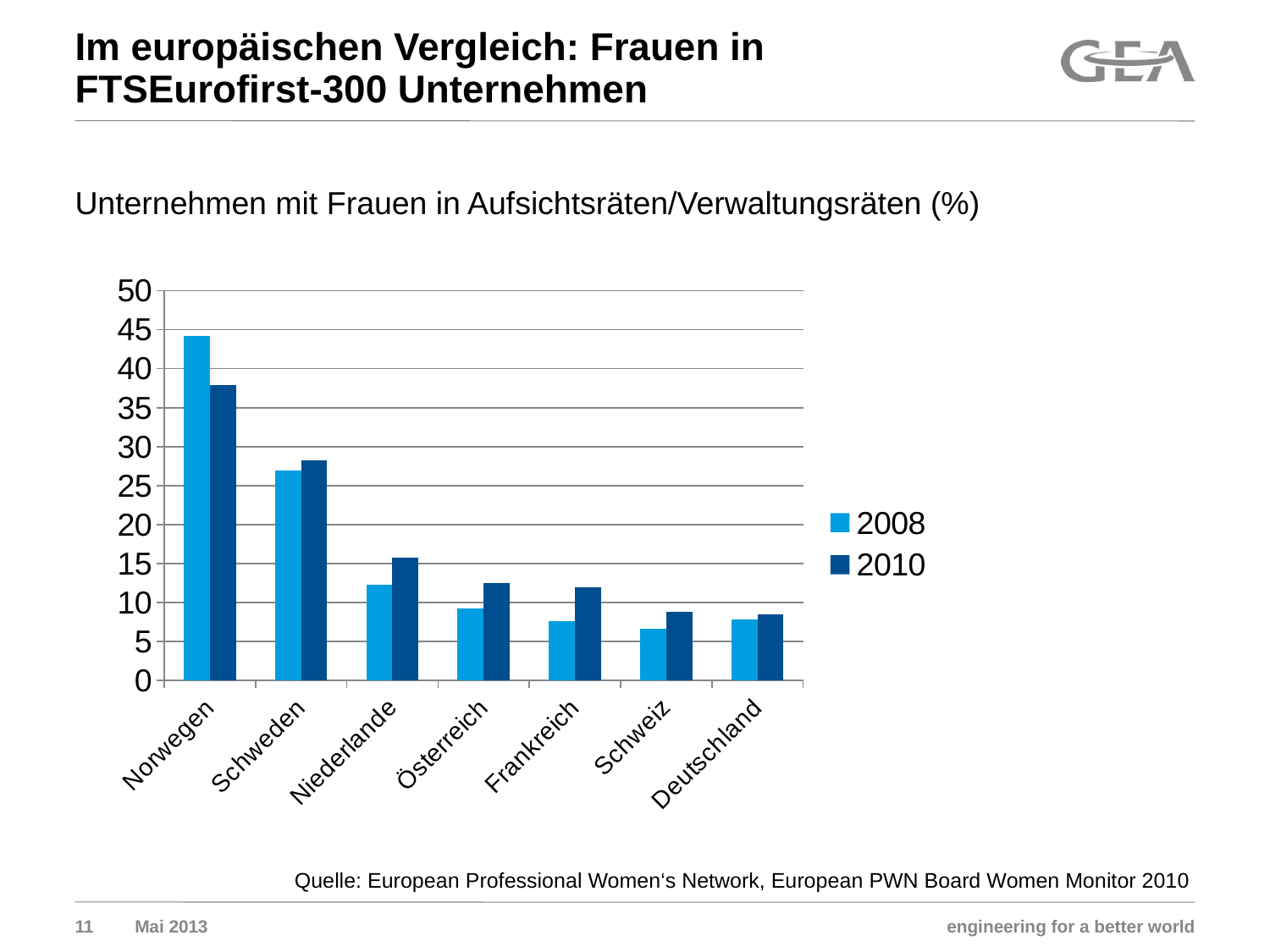
For Niederlande, which year has the larger value, 2008 or 2010? 2010 Which country has the highest value for 2008? Norwegen Is the 2010 value for Norwegen greater or less than 40? less Which years are listed in the chart legend? 2008 and 2010 Is the 2008 value for Norwegen greater or less than 40? greater What kind of chart is shown on the slide? bar chart Is the 2010 value for Frankreich greater or less than 10? greater How many countries are shown on the x axis of the chart? 7 For Norwegen, which year has the larger value, 2008 or 2010? 2008 How many series does the chart legend list? 2 Which country has the highest value for 2010? Norwegen